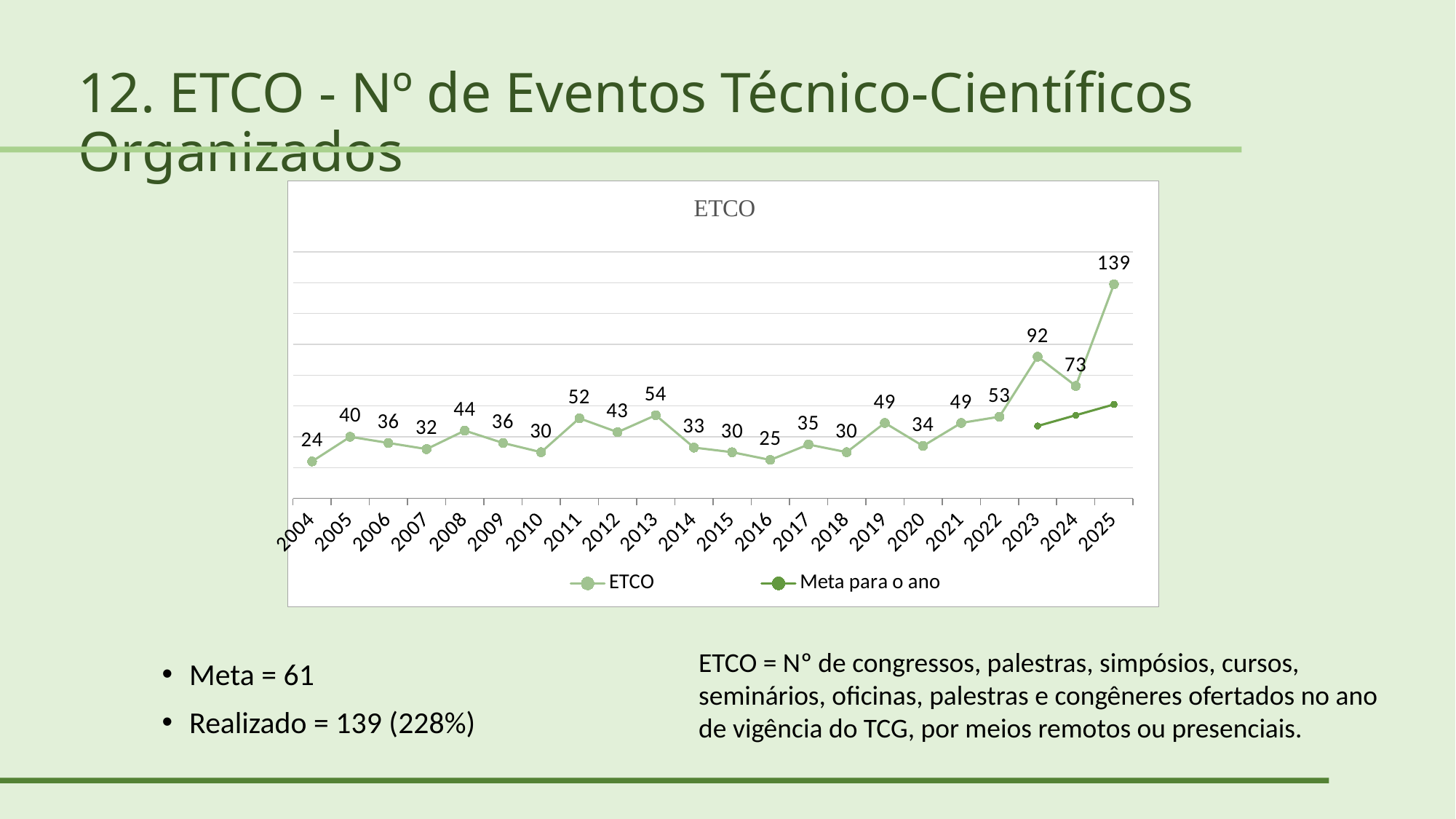
What is the ETCO value for 2004? 24 Which year has the lowest ETCO value? 2004 What is the difference between the ETCO values for 2023 and 2022? 39 What is the ETCO value for 2025? 139 Which year has the highest ETCO value? 2025 What kind of chart is shown on the slide? Line chart How many series does the chart legend list? 2 How many years are shown on the x axis of the chart? 22 What is the ETCO value for 2013? 54 What is the difference between the ETCO values for 2025 and 2024? 66 Which year has a larger ETCO value, 2011 or 2012? 2011 What are the two series named in the chart legend? ETCO and Meta para o ano